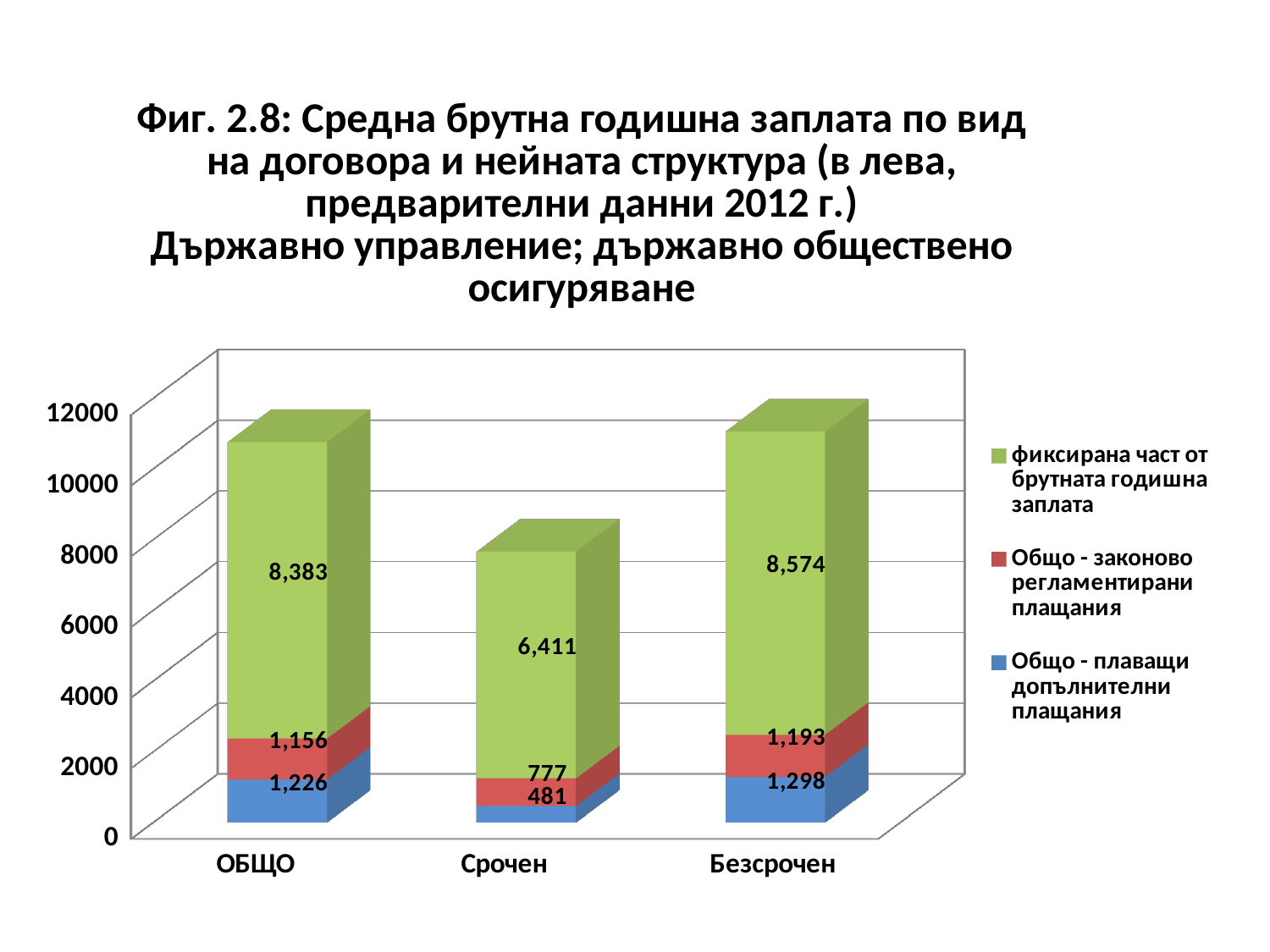
What is the value of 'фиксирана част от брутната годишна заплата' for Срочен? 6,411 Which category has the lowest value for 'Общо - плаващи допълнителни плащания'? Срочен What is the value of 'Общо - плаващи допълнителни плащания' for Безсрочен? 1,298 What type of chart is shown on the slide? Stacked bar chart What is the difference between the 'фиксирана част от брутната годишна заплата' values for Безсрочен and Срочен? 2,163 How many series does the legend list? 3 Which category has the highest value for 'фиксирана част от брутната годишна заплата'? Безсрочен What is the total of the stacked bar for Безсрочен? 11,065 Which is larger: 'Общо - законово регламентирани плащания' for Безсрочен or for ОБЩО? Безсрочен What is the value of 'Общо - законово регламентирани плащания' for ОБЩО? 1,156 How many categories are shown on the x axis? 3 What is the total of the stacked bar for Срочен? 7,669